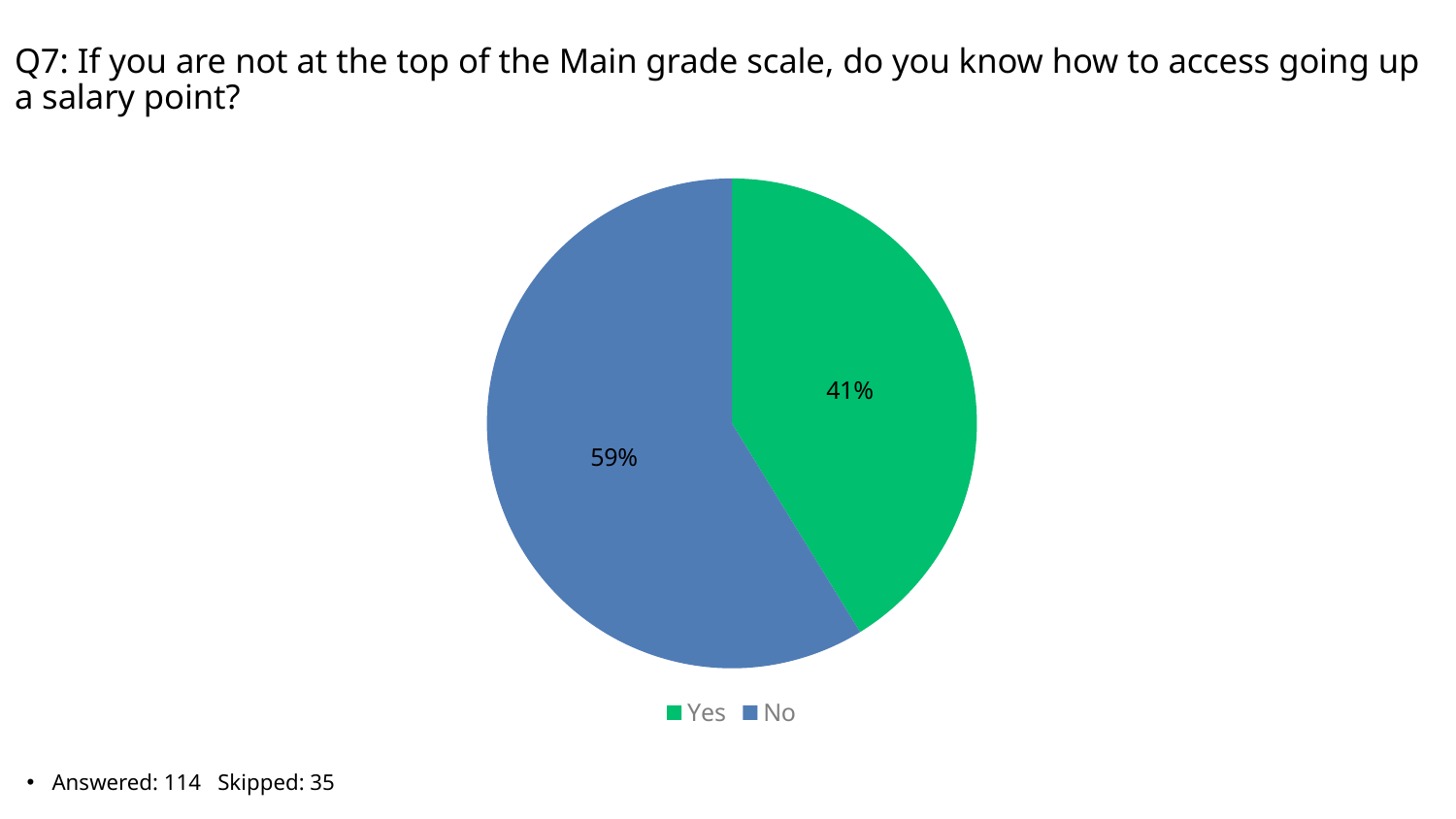
What percentage of respondents answered Yes? 41% What is the difference in percentage points between the No and Yes slices? 18 How many slices does the pie chart have? 2 How many respondents answered this question according to the slide? 114 Which response has the larger share of the pie? No Is the share for Yes larger or smaller than the share for No? smaller What share of the pie does the No slice represent? 59% What kind of chart is shown on the slide? pie chart Which colour represents the Yes slice? green What percentage of respondents answered No? 59% How many entries does the legend list? 2 Which response has the smaller share of the pie? Yes